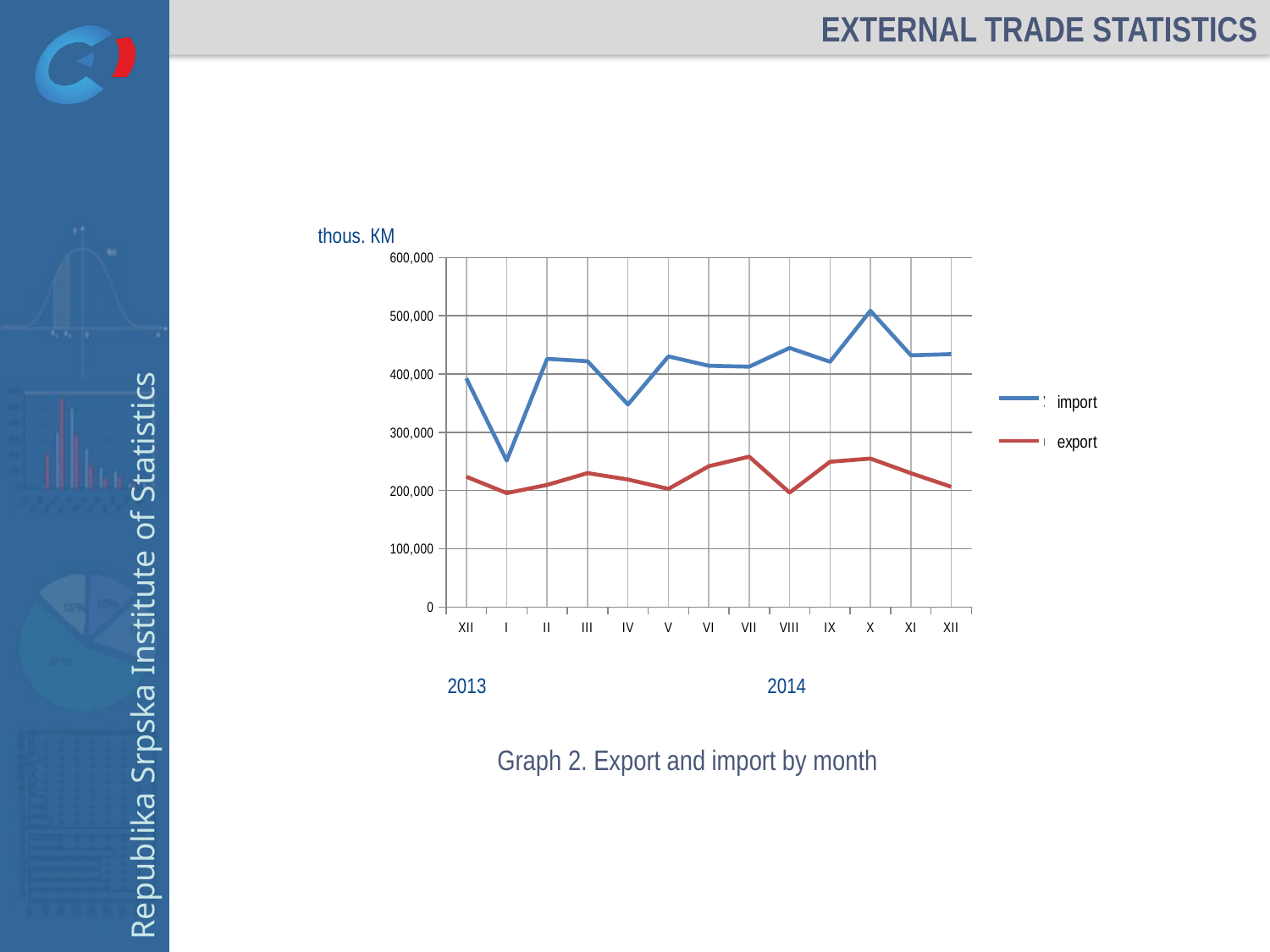
How many months are plotted along the x axis? 13 Does the export value rise or fall from month VIII to month X of 2014? rise Is the export value for month VII of 2014 greater or less than 200,000? greater In which month is the import value lowest? I (2014) Which is larger in month V of 2014, import or export? import Which colour represents export in the legend? red How many series does the legend list? 2 What unit is shown above the y axis? thous. KM What kind of chart is shown on the slide? line chart In which month is the import value highest? X (2014) Is the import value for month I of 2014 greater or less than 300,000? less